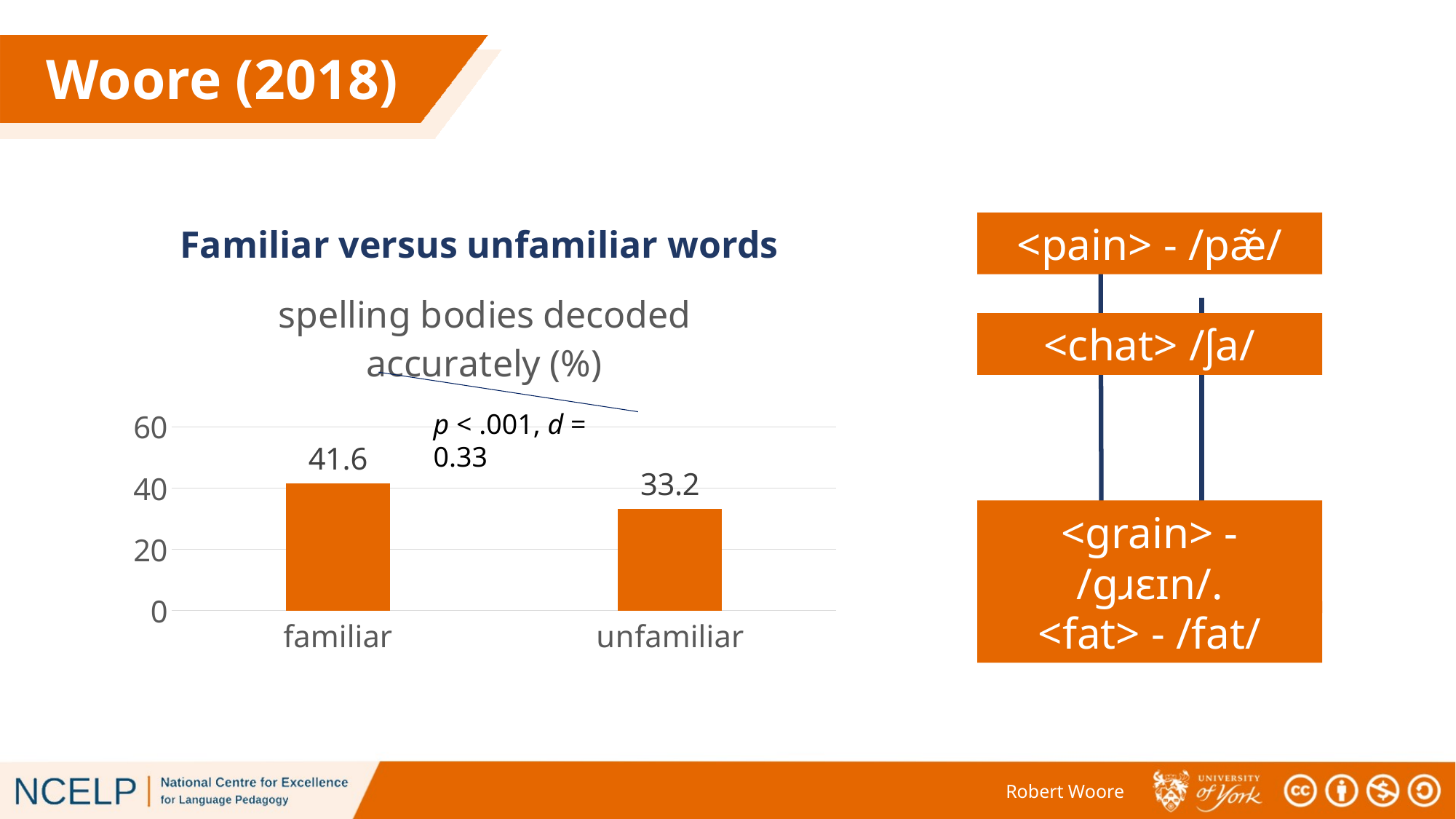
What kind of chart is shown on the slide? bar chart Is the value for familiar words greater or less than 40? greater What is the value for unfamiliar words in the chart? 33.2 Which category has the higher value, familiar or unfamiliar? familiar What is the value for familiar words in the chart? 41.6 Which category has the lowest value in the chart? unfamiliar How many categories are shown in the chart? 2 What is the difference between the familiar and unfamiliar values? 8.4 Is the value for unfamiliar words greater or less than 40? less What is the title of the chart? spelling bodies decoded accurately (%) What is the highest value shown on the chart's vertical axis? 60 Do the values rise or fall from familiar to unfamiliar? fall